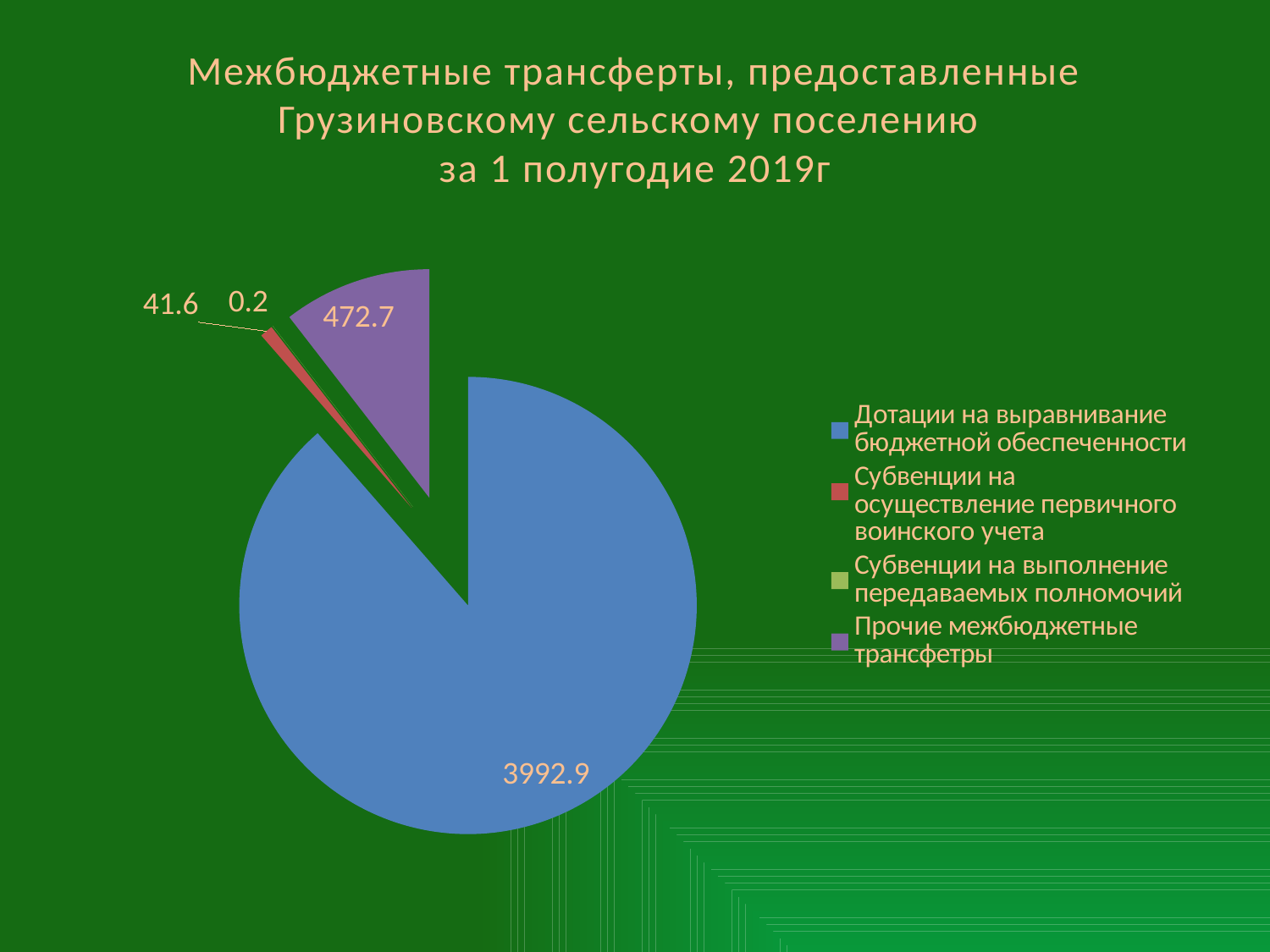
What is the difference between the values for Дотации на выравнивание бюджетной обеспеченности and Прочие межбюджетные трансфетры? 3520.2 Which category has the smallest slice of the pie? Субвенции на выполнение передаваемых полномочий What is the value for Субвенции на выполнение передаваемых полномочий? 0.2 Which category has the largest slice of the pie? Дотации на выравнивание бюджетной обеспеченности Which is larger: Прочие межбюджетные трансфетры or Субвенции на осуществление первичного воинского учета? Прочие межбюджетные трансфетры What is the value for Субвенции на осуществление первичного воинского учета? 41.6 What is the value for Прочие межбюджетные трансфетры? 472.7 How many categories does the pie chart show? 4 What colour is the slice for Прочие межбюджетные трансфетры? Purple What kind of chart is shown on the slide? Pie chart What is the value for Дотации на выравнивание бюджетной обеспеченности? 3992.9 What is the difference between the values for Прочие межбюджетные трансфетры and Субвенции на осуществление первичного воинского учета? 431.1